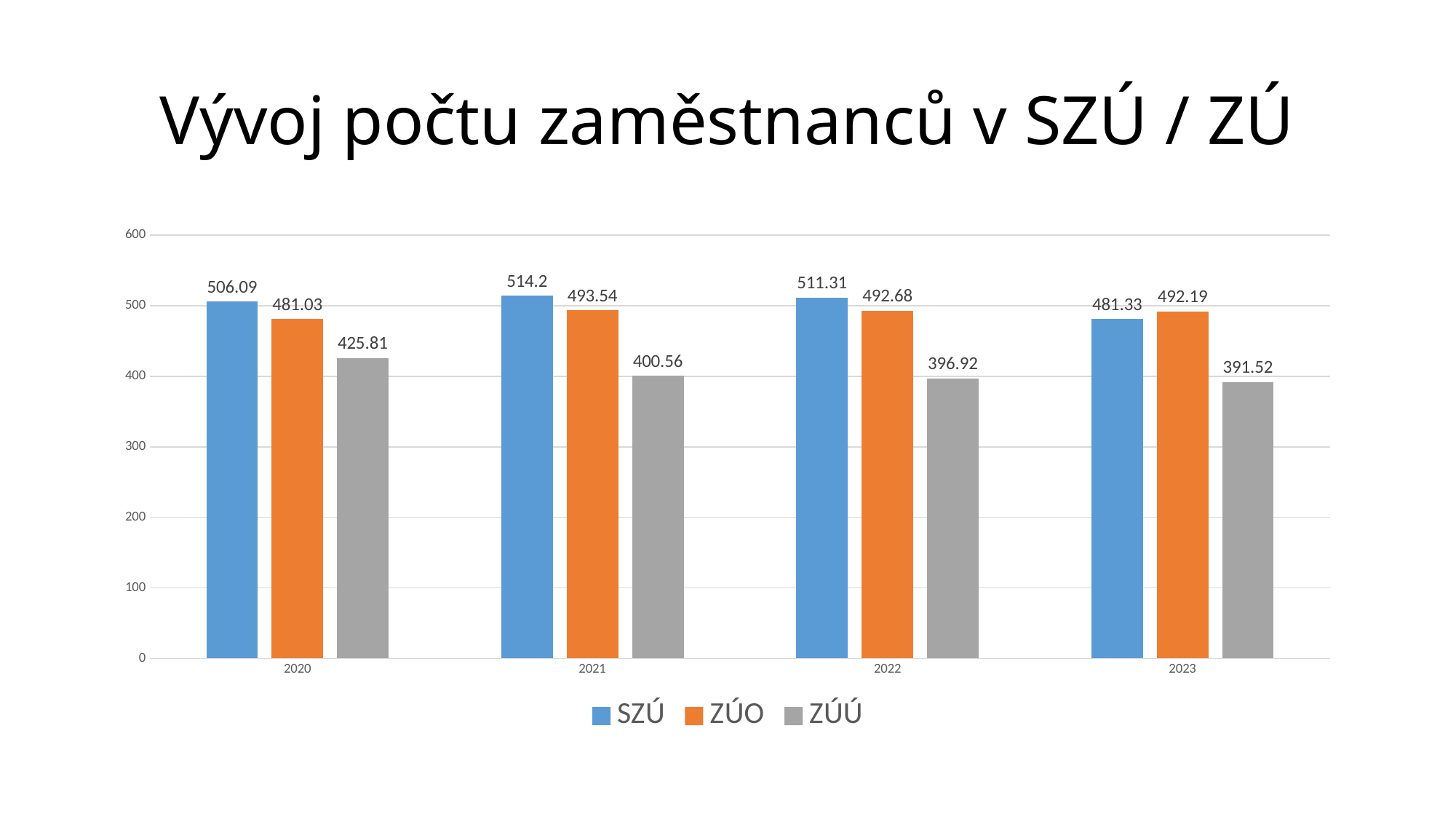
What is the difference between the ZÚÚ values for 2020 and 2023? 34.29 Do the ZÚÚ values rise or fall from 2020 to 2023? fall What is the value for ZÚO in 2023? 492.19 In which year is the ZÚÚ value lowest? 2023 What is the value for ZÚÚ in 2020? 425.81 Is the value for ZÚÚ in 2022 greater or less than 400? less How many series does the legend list? 3 In 2023, which is larger, SZÚ or ZÚO? ZÚO What is the difference between the SZÚ values for 2021 and 2023? 32.87 How many years are shown on the x axis? 4 What is the value for SZÚ in 2021? 514.2 In which year is the SZÚ value highest? 2021